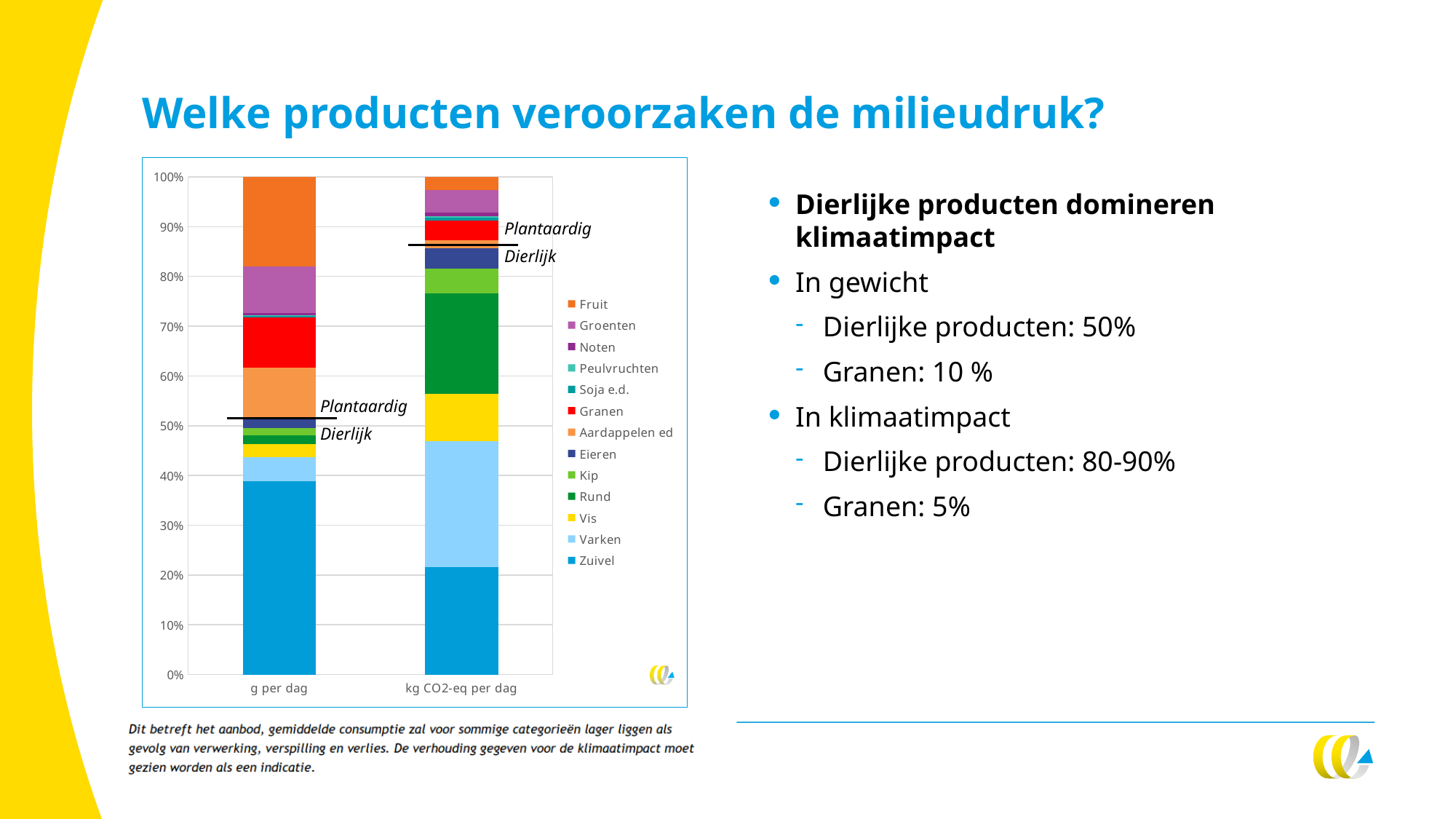
How many series does the chart legend list? 13 Which series is listed first in the chart legend? Fruit Is the Zuivel share in the 'g per dag' bar greater or less than 30%? greater How many bars (categories) are plotted on the x axis of the chart? 2 Is the Zuivel share in the 'kg CO2-eq per dag' bar greater or less than 30%? less Is the Zuivel share in the 'kg CO2-eq per dag' bar greater or less than 20%? greater What is the total height of the 'g per dag' stacked bar? 100% Which series takes the largest share of the 'g per dag' bar? Zuivel What kind of chart is shown on the slide? Stacked bar chart Is the Fruit share larger in the 'g per dag' bar or in the 'kg CO2-eq per dag' bar? g per dag What are the two category labels on the x axis of the chart? g per dag and kg CO2-eq per dag Is the Rund share larger in the 'g per dag' bar or in the 'kg CO2-eq per dag' bar? kg CO2-eq per dag